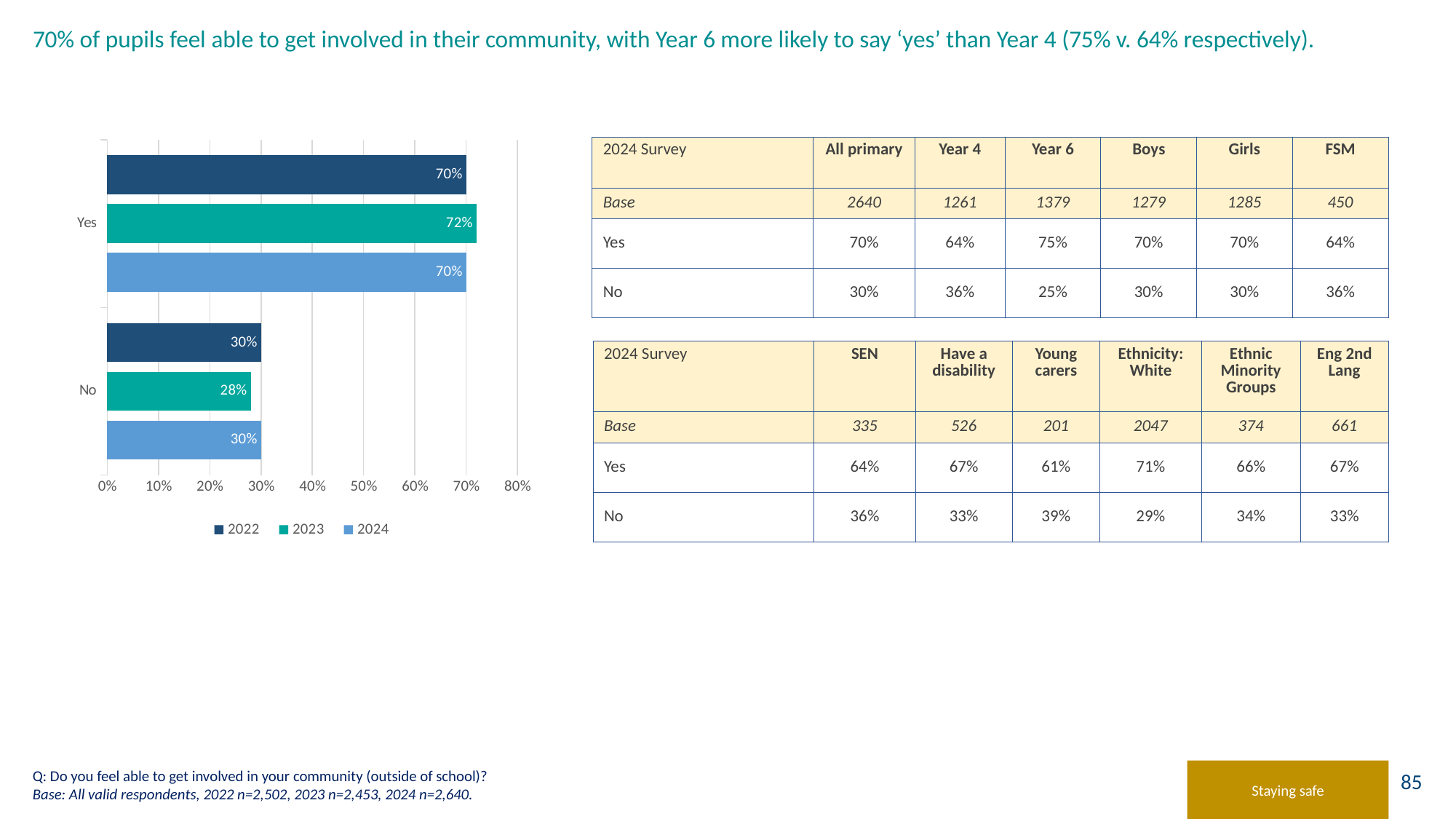
How many series does the chart legend list? 3 What is the difference between the 'Yes' value in 2023 and the 'Yes' value in 2024? 2% What percentage of pupils answered 'No' in 2023? 28% Which years are listed in the chart legend? 2022, 2023, 2024 How many response categories are shown on the chart? 2 Which year has the highest 'Yes' value? 2023 Is the 'No' value for 2022 larger or smaller than the 'No' value for 2023? larger What percentage of pupils answered 'Yes' in 2024? 70% Is the 'Yes' value for 2023 greater or less than 60%? greater What kind of chart is shown on the slide? bar chart Which year has the lowest 'No' value? 2023 What percentage of pupils answered 'Yes' in 2022? 70%